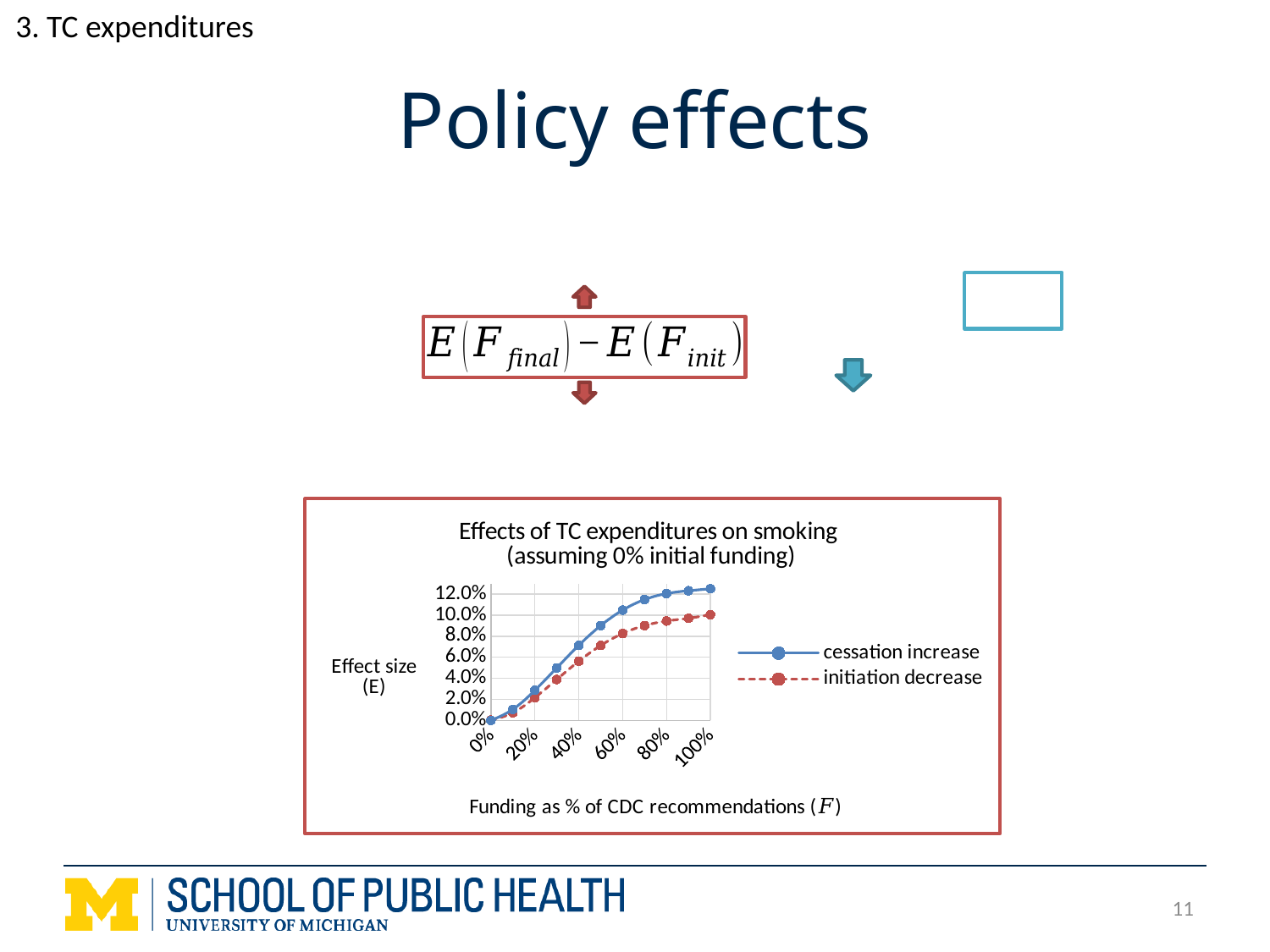
Is the value of the initiation decrease series at 100% funding greater or less than 8.0%? greater What kind of chart is shown on the slide? line chart How many series does the chart legend list? 2 What are the two series named in the chart legend? cessation increase, initiation decrease Do the values of the initiation decrease series rise or fall as funding increases along the x axis? rise What is the title of the chart? Effects of TC expenditures on smoking (assuming 0% initial funding) Is the value of the cessation increase series at 60% funding greater or less than 8.0%? greater Do the values of the cessation increase series rise or fall as funding increases along the x axis? rise Is the value of the cessation increase series at 100% funding greater or less than 10.0%? greater At 100% funding, which series has the larger value, cessation increase or initiation decrease? cessation increase What is the value of the cessation increase series at 0% funding? 0.0%